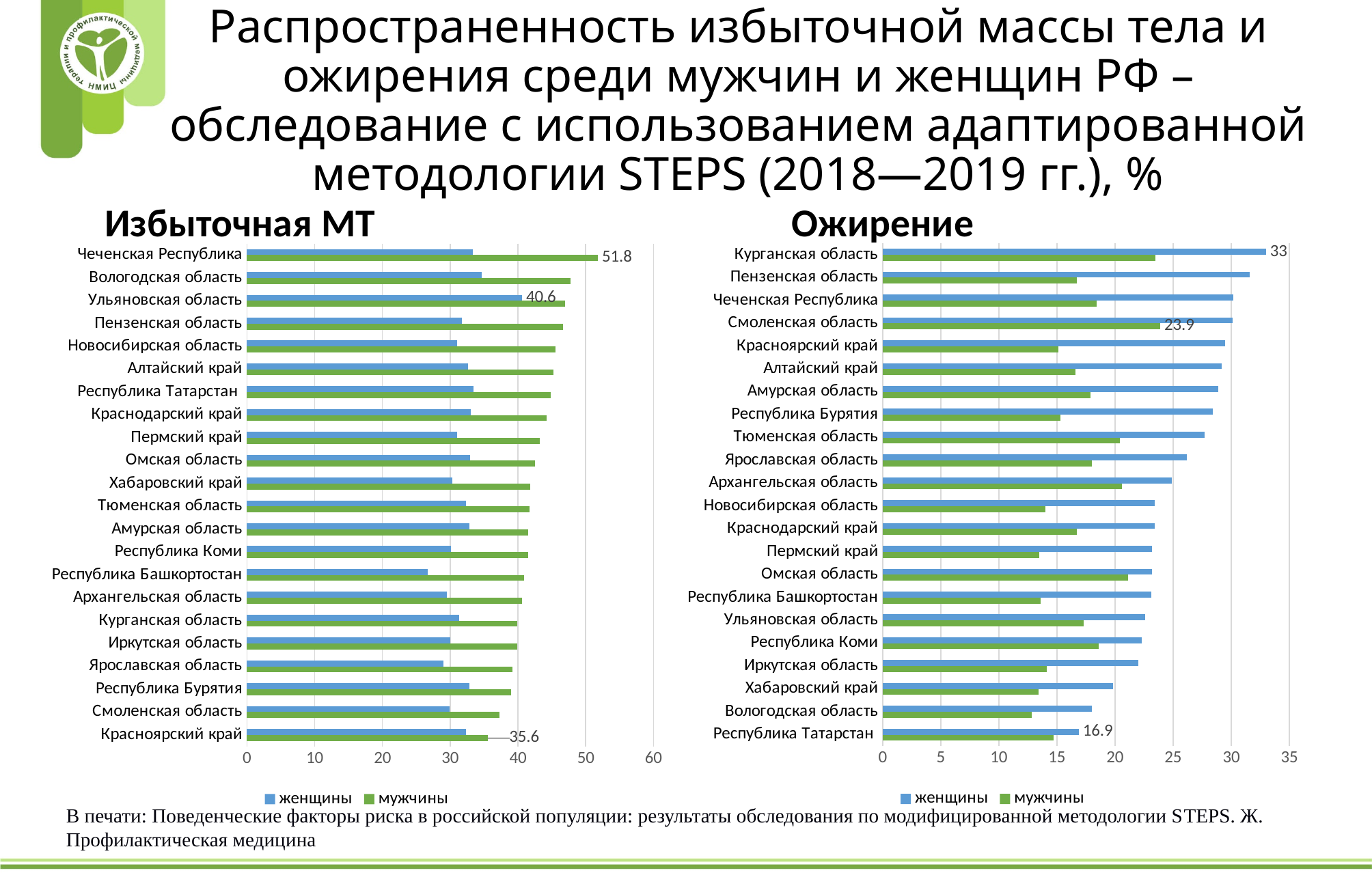
On the 'Избыточная МТ' chart, what is the difference between the мужчины values for Чеченская Республика and Красноярский край? 16.2 On the 'Избыточная МТ' chart, what is the value for мужчины in Чеченская Республика? 51.8 On the 'Ожирение' chart, what is the value for женщины in Курганская область? 33 How many series does the legend of the 'Ожирение' chart list? 2 On the 'Ожирение' chart, is the value for женщины in Курганская область larger than the value for мужчины in the same region? Yes, женщины On the 'Ожирение' chart, which region has the highest value for женщины? Курганская область On the 'Ожирение' chart, what is the value for женщины in Республика Татарстан? 16.9 On the 'Избыточная МТ' chart, what is the value for мужчины in Красноярский край? 35.6 On the 'Избыточная МТ' chart, what is the value for женщины in Ульяновская область? 40.6 On the 'Избыточная МТ' chart, is the value for женщины in Республика Башкортостан greater or less than 30? less On the 'Избыточная МТ' chart, which region has the highest value for мужчины? Чеченская Республика On the 'Ожирение' chart, what is the value for мужчины in Смоленская область? 23.9